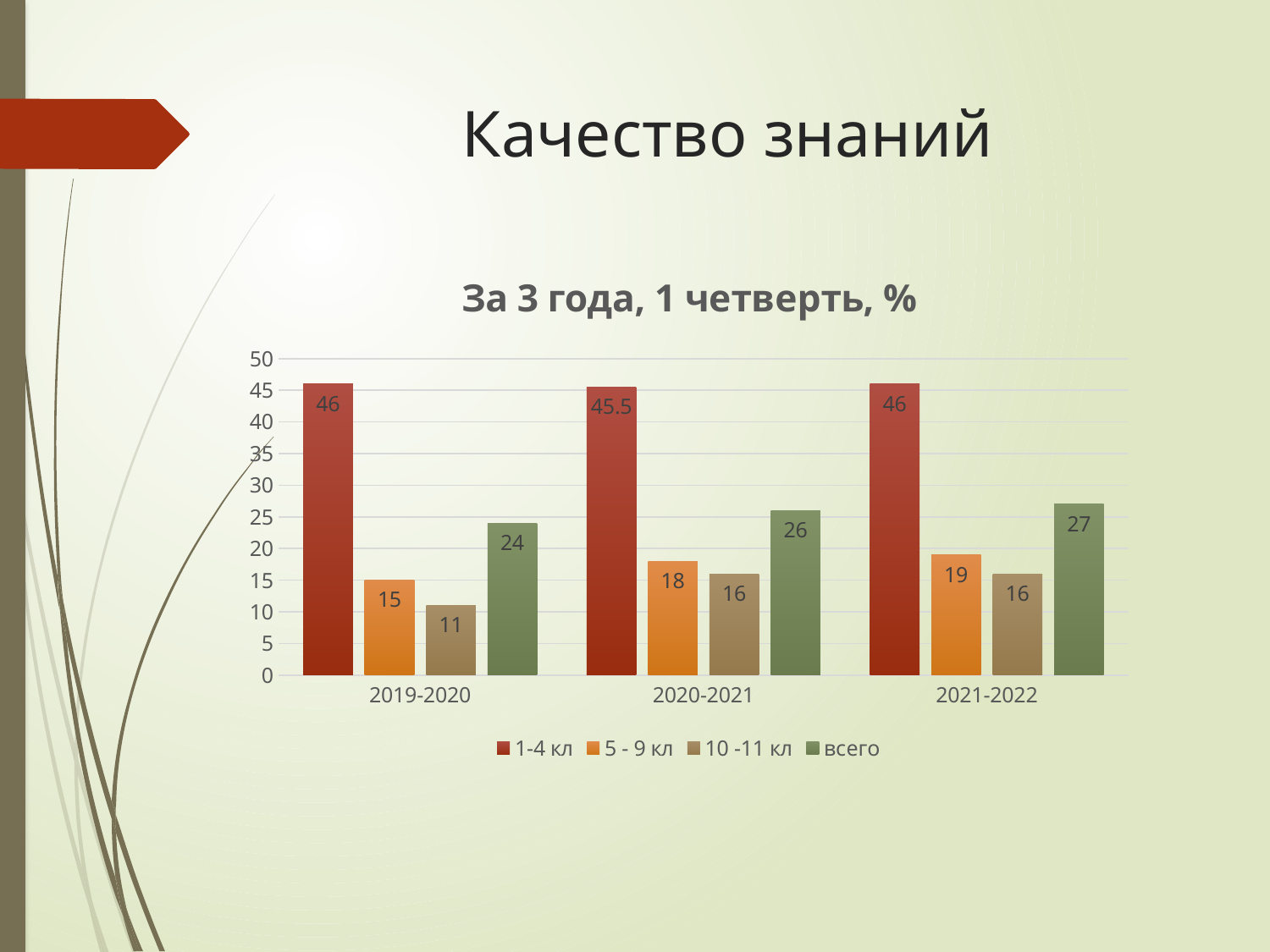
How many series does the legend list? 4 Which is larger: the 5 - 9 кл value in 2021-2022 or the 10 -11 кл value in 2021-2022? 5 - 9 кл in 2021-2022 How many year categories are shown on the x axis? 3 What is the difference between the всего values for 2021-2022 and 2019-2020? 3 What is the value for 10 -11 кл in 2019-2020? 11 Do the всего values rise or fall from 2019-2020 to 2021-2022? rise What is the value for всего in 2021-2022? 27 Which series has the lowest value in 2019-2020? 10 -11 кл What is the value for 1-4 кл in 2020-2021? 45.5 What is the value for 5 - 9 кл in 2020-2021? 18 Which series has the highest value in 2021-2022? 1-4 кл What kind of chart is shown on the slide? bar chart